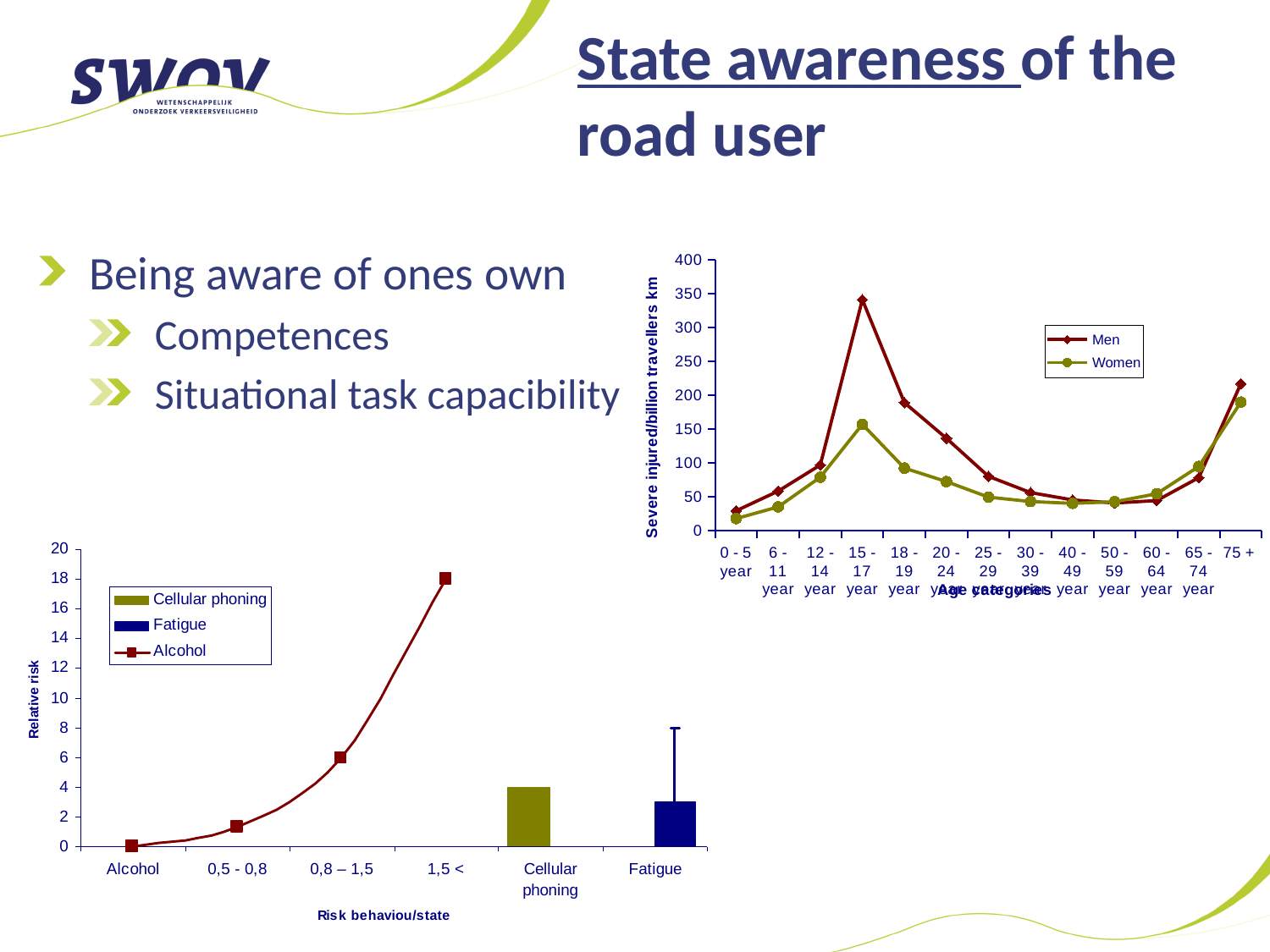
In the top-right chart, is the value for Women at 15 - 17 year greater or less than 200? less In the top-right chart, which age category has the highest value for Men? 15 - 17 year In the top-right chart, which series has the higher value at 18 - 19 year, Men or Women? Men In the bottom-left chart, what is the label of the x axis? Risk behaviou/state In the bottom-left chart, what is the relative risk shown by the Cellular phoning bar? 4 In the bottom-left chart, what is the relative risk for the Alcohol category at 0,8 – 1,5? 6 In the top-right chart, how many series does the legend list? 2 In the bottom-left chart, how many series does the legend list? 3 In the top-right chart, is the value for Men at 15 - 17 year greater or less than 300? greater In the bottom-left chart, what is the relative risk for the Alcohol category at 1,5 <? 18 In the bottom-left chart, is the relative risk for Fatigue greater or less than 4? less In the bottom-left chart, which category has the highest relative risk? 1,5 <